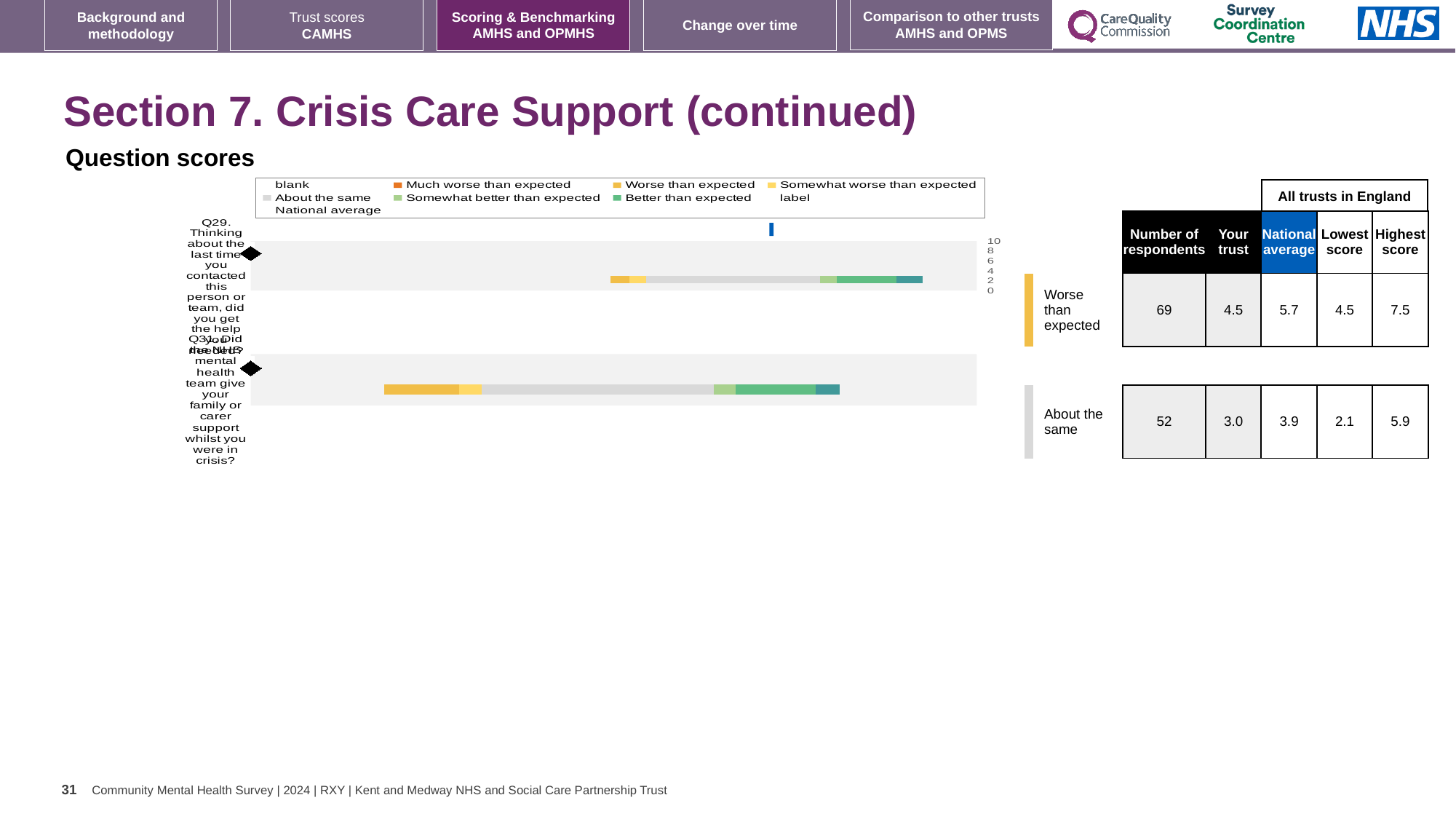
Which question in the chart is rated 'About the same'? Q31 In the table beside the chart, what is the 'Your trust' score for Q31? 3.0 In the table beside the chart, which question has more respondents, Q29 or Q31? Q29 In the table beside the chart, how much higher is the national average than the 'Your trust' score for Q29? 1.2 In the table beside the chart, what is the difference between the highest and lowest scores for Q29? 3.0 Which question in the chart is rated 'Worse than expected'? Q29 In the table beside the chart, for Q31 which is larger, the 'Your trust' score or the national average? National average In the table beside the chart, what is the national average score for Q29? 5.7 What kind of chart is used to show the question scores for Q29 and Q31? bar chart How many questions are plotted in the question scores chart? 2 In the table beside the chart, how many respondents are listed for Q29? 69 In the table beside the chart, what is the highest score for Q31? 5.9